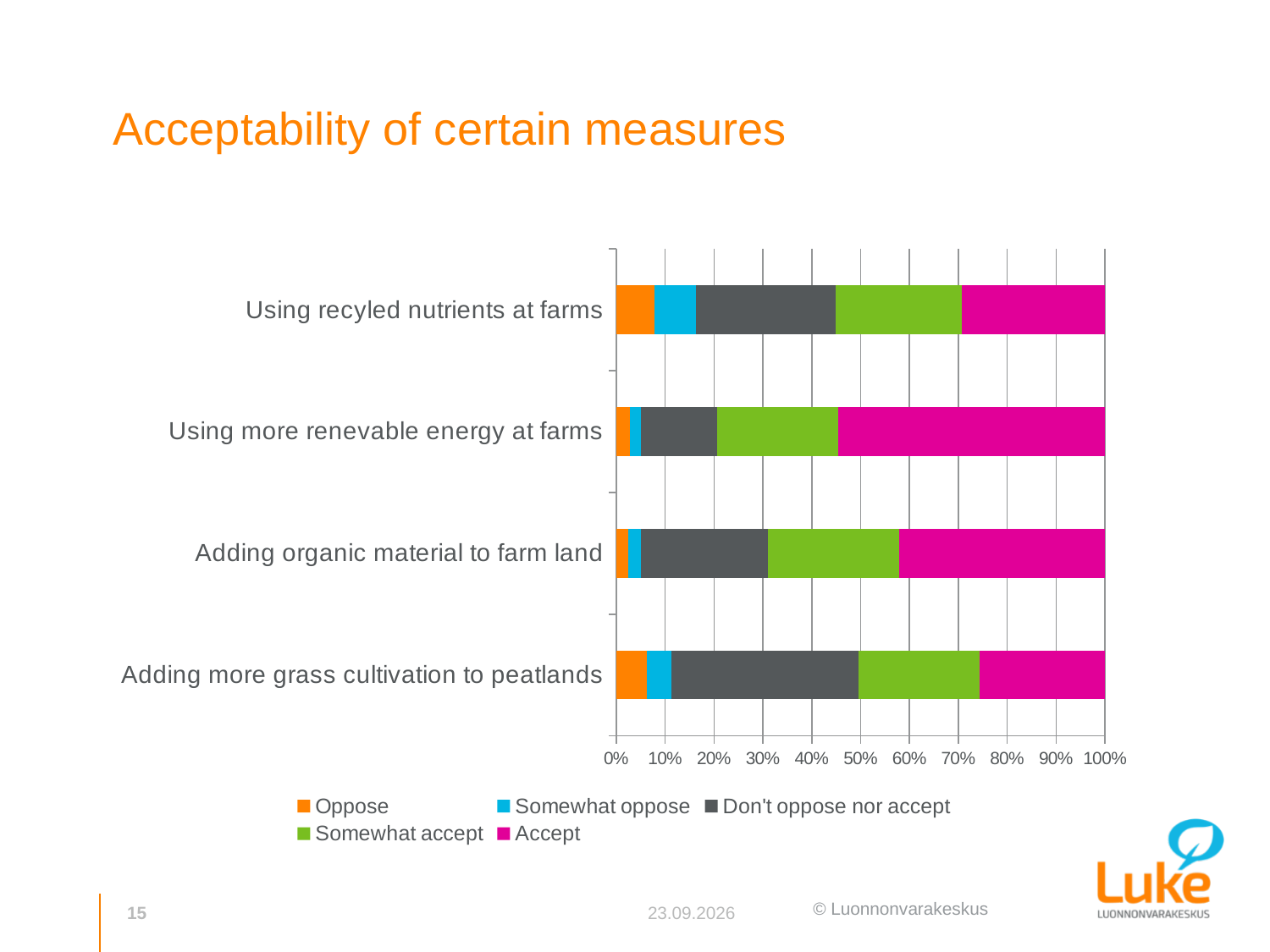
What kind of chart is shown on the slide? Stacked bar chart Is the 'Accept' share for 'Using more renevable energy at farms' greater or less than 50%? greater How many measures (categories) are shown in the chart? 4 What is the total of the stacked bar for 'Adding organic material to farm land'? 100% Which has a larger 'Oppose' segment: 'Using recyled nutrients at farms' or 'Using more renevable energy at farms'? Using recyled nutrients at farms Is the 'Don't oppose nor accept' share for 'Adding more grass cultivation to peatlands' greater or less than 30%? greater How many series does the legend list? 5 What is the title of the slide's chart section? Acceptability of certain measures Which measure has the largest 'Accept' segment? Using more renevable energy at farms Which measure has the largest 'Don't oppose nor accept' segment? Adding more grass cultivation to peatlands Which has a larger 'Don't oppose nor accept' segment: 'Adding more grass cultivation to peatlands' or 'Using more renevable energy at farms'? Adding more grass cultivation to peatlands Is the 'Oppose' share for 'Using recyled nutrients at farms' greater or less than 5%? greater